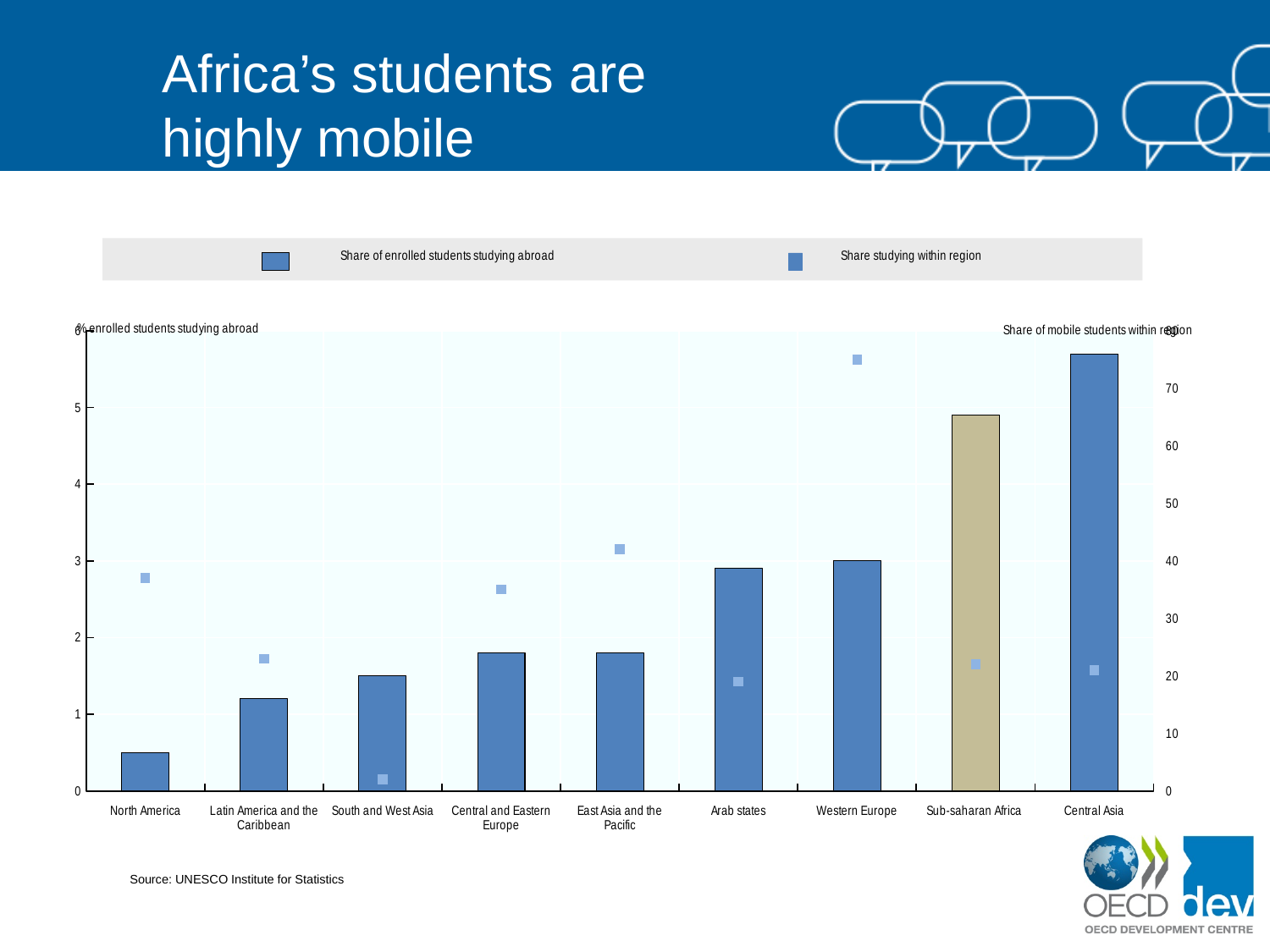
Which region has the highest share of enrolled students studying abroad (tallest bar)? Central Asia Is the share of enrolled students studying abroad for North America greater or less than 1? less Which region's bar is drawn in a different colour (tan) from the others? Sub-saharan Africa Is the share of enrolled students studying abroad for Sub-saharan Africa greater or less than 4? greater Is the share of mobile students studying within region for Western Europe greater or less than 70? greater Which region has the lowest share of enrolled students studying abroad (shortest bar)? North America Which region has the lowest share of mobile students studying within region (lowest marker)? South and West Asia Which region has the highest share of mobile students studying within region (highest marker)? Western Europe How many regions are shown on the x axis? 9 Which has a larger share of enrolled students studying abroad, Sub-saharan Africa or Arab states? Sub-saharan Africa How many series does the legend list? 2